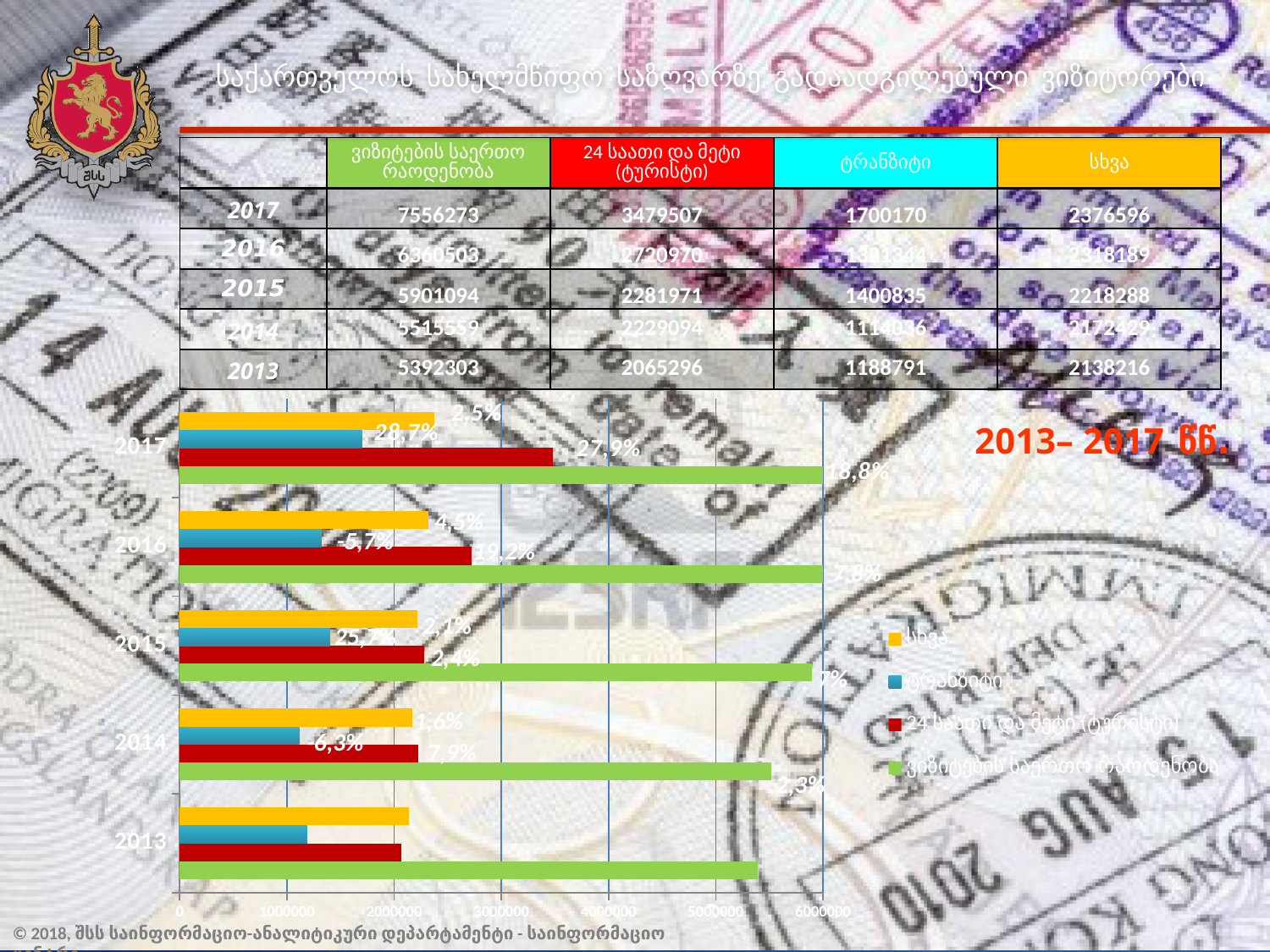
For 2017, which is larger: the red (24 საათი და მეტი) bar or the blue (ტრანზიტი) bar? red (24 საათი და მეტი) What data label is printed next to the red (24 საათი და მეტი) bar for 2017? 27,9% Is the value of the red (24 საათი და მეტი) bar for 2017 greater or less than 3000000? greater How many series does the chart legend list? 4 Is the value of the blue (ტრანზიტი) bar for 2014 greater or less than 2000000? less Do the green (ვიზიტების საერთო რაოდენობა) bars rise or fall from 2013 to 2017? rise Which year has the shortest green (ვიზიტების საერთო რაოდენობა) bar? 2013 How many years are shown as categories on the chart? 5 What kind of chart is shown on the slide? bar chart Which year has the longest green (ვიზიტების საერთო რაოდენობა) bar? 2017 Which series is shown in green in the chart legend? ვიზიტების საერთო რაოდენობა Is the value of the green (ვიზიტების საერთო რაოდენობა) bar for 2013 greater or less than 5000000? greater